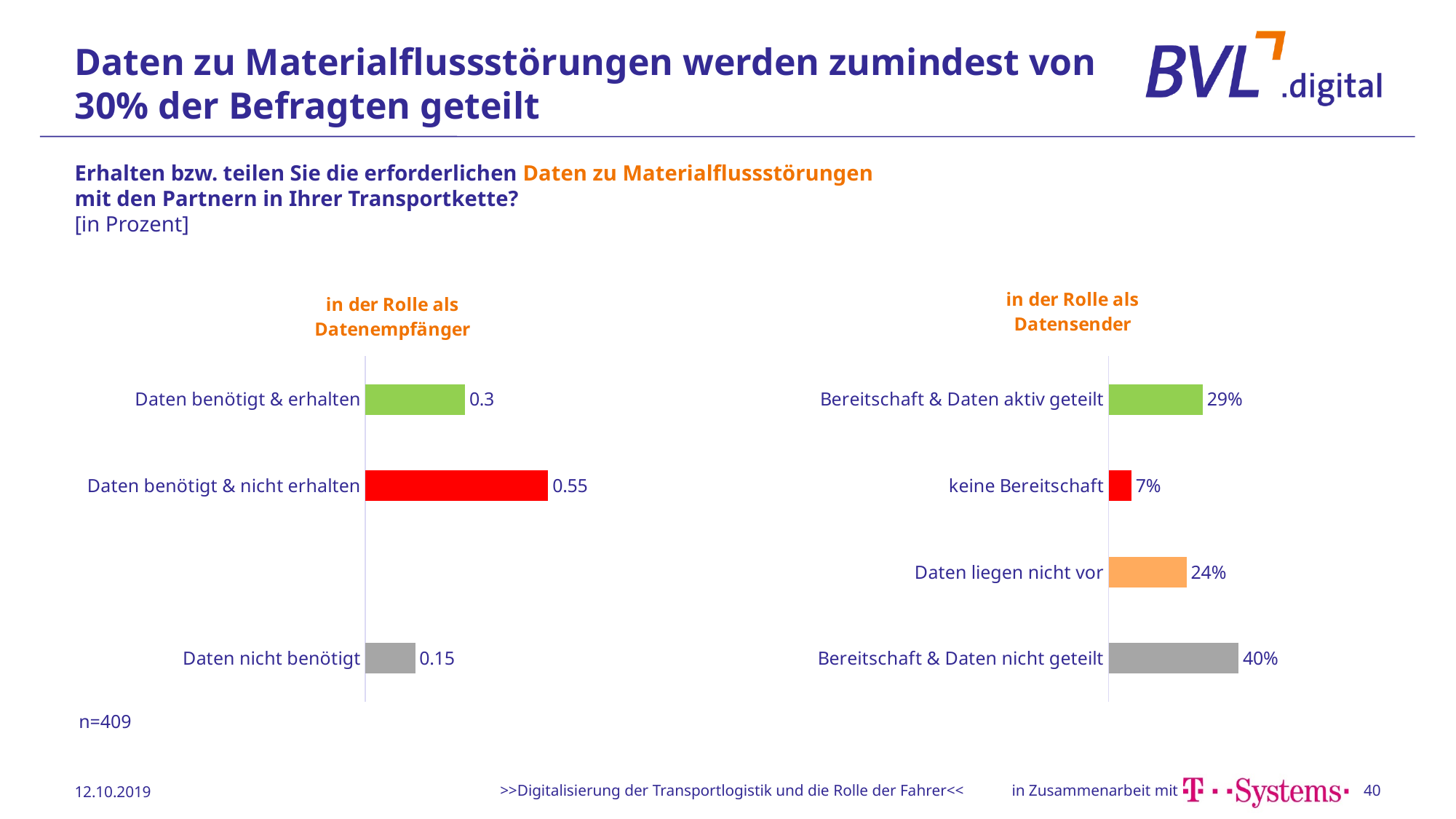
In the chart 'in der Rolle als Datensender', which category has the highest value? Bereitschaft & Daten nicht geteilt In the chart 'in der Rolle als Datenempfänger', what is the value for 'Daten benötigt & nicht erhalten'? 0.55 What colour is the bar for 'keine Bereitschaft' in the chart 'in der Rolle als Datensender'? Red In the chart 'in der Rolle als Datensender', what is the difference between 'Bereitschaft & Daten nicht geteilt' and 'Bereitschaft & Daten aktiv geteilt'? 11% In the chart 'in der Rolle als Datensender', which is larger: 'Bereitschaft & Daten aktiv geteilt' or 'Daten liegen nicht vor'? Bereitschaft & Daten aktiv geteilt In the chart 'in der Rolle als Datenempfänger', which category has the lowest value? Daten nicht benötigt In the chart 'in der Rolle als Datensender', what is the value for 'Daten liegen nicht vor'? 24% How many categories are shown in the chart 'in der Rolle als Datensender'? 4 In the chart 'in der Rolle als Datensender', what is the value for 'keine Bereitschaft'? 7% In the chart 'in der Rolle als Datenempfänger', what is the difference between 'Daten benötigt & nicht erhalten' and 'Daten benötigt & erhalten'? 0.25 What kind of chart is the chart 'in der Rolle als Datenempfänger'? Bar chart In the chart 'in der Rolle als Datenempfänger', what is the value for 'Daten nicht benötigt'? 0.15